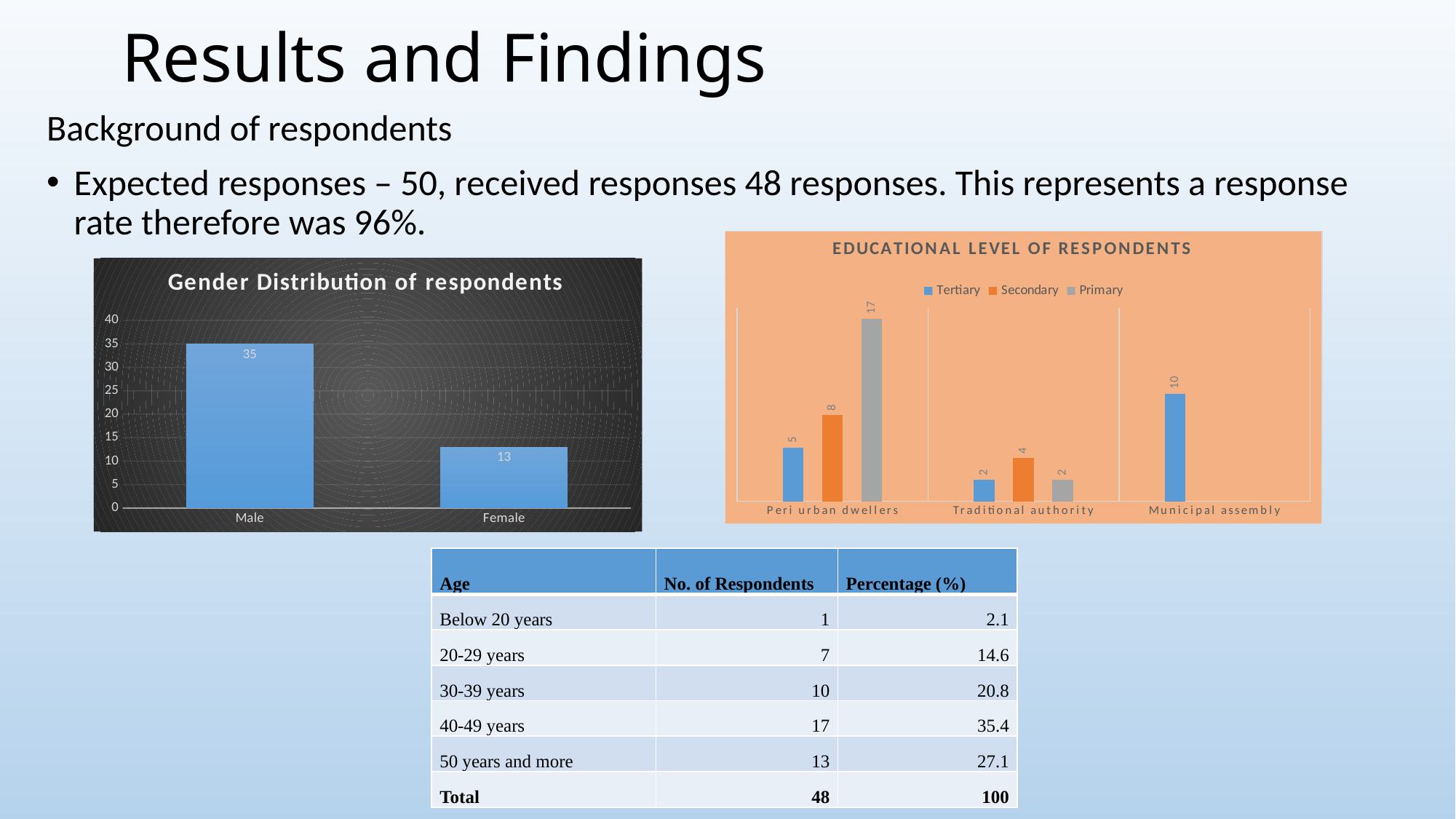
What kind of chart is the 'Gender Distribution of respondents' chart? Bar chart In the 'Educational Level of Respondents' chart, what is the Secondary value for Traditional authority? 4 In the 'Educational Level of Respondents' chart, is the Secondary value for Peri urban dwellers larger or smaller than the Tertiary value for Peri urban dwellers? Larger In the 'Educational Level of Respondents' chart, which category has the highest Primary value? Peri urban dwellers In the 'Gender Distribution of respondents' chart, what is the value for Female? 13 In the 'Educational Level of Respondents' chart, what is the Tertiary value for Municipal assembly? 10 In the 'Educational Level of Respondents' chart, how many series does the legend list? 3 In the 'Educational Level of Respondents' chart, what is the difference between the Primary value for Peri urban dwellers and the Primary value for Traditional authority? 15 In the 'Gender Distribution of respondents' chart, what is the value for Male? 35 In the 'Educational Level of Respondents' chart, what is the Primary value for Peri urban dwellers? 17 In the 'Gender Distribution of respondents' chart, how many categories are shown on the x axis? 2 In the 'Gender Distribution of respondents' chart, what is the difference between the Male and Female values? 22